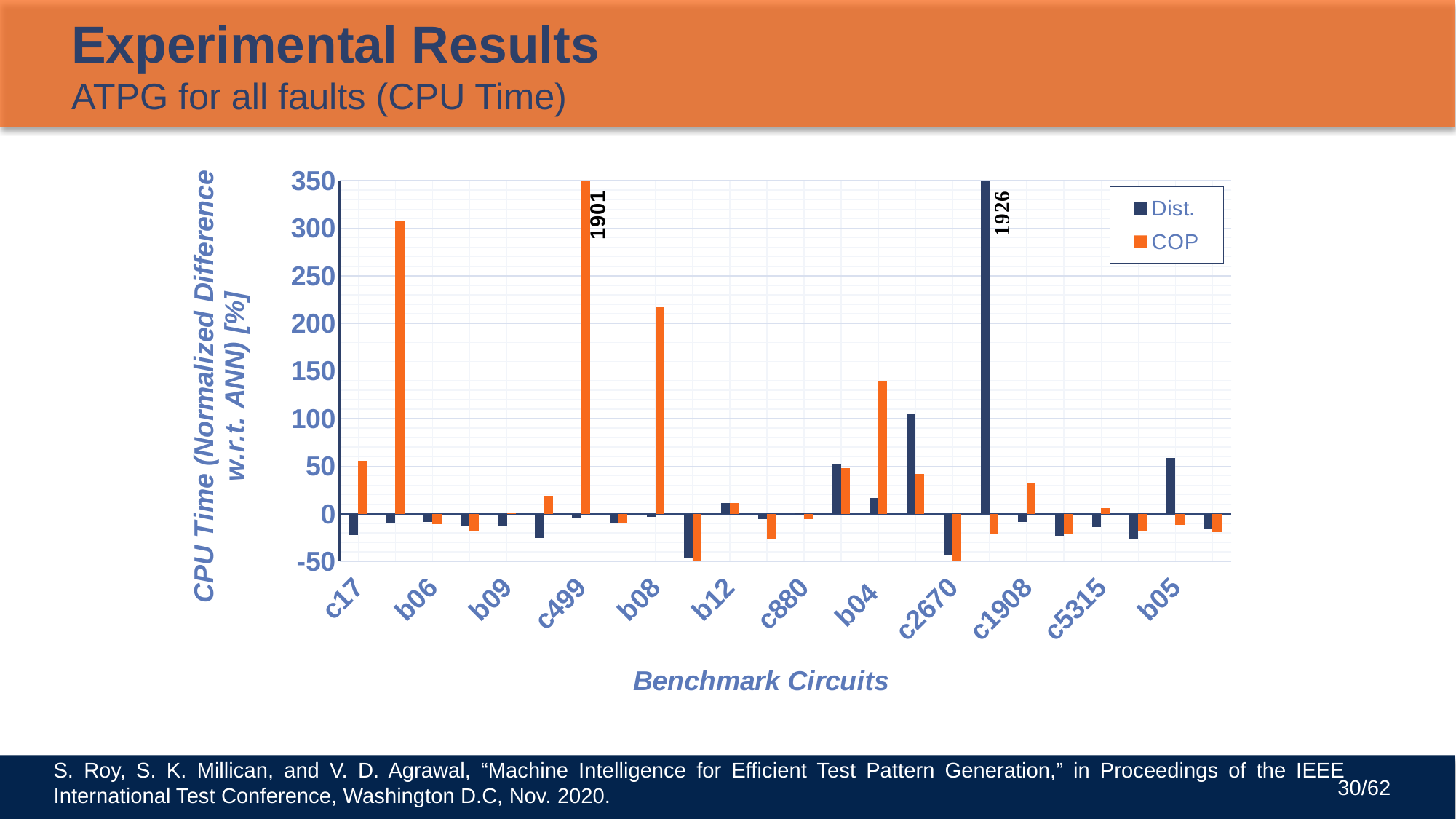
What kind of chart is shown on the slide? bar chart What is the title of the y axis? CPU Time (Normalized Difference w.r.t. ANN) [%] Which series does the bar labeled 1901 belong to? COP What is the highest value printed on the chart? 1926 What are the two series named in the legend? Dist. and COP How many series does the legend list? 2 Which is larger, the labeled Dist. bar (1926) or the labeled COP bar (1901)? Dist. (1926) What is the highest tick value shown on the y axis? 350 What is the difference between the two printed data labels, 1926 and 1901? 25 Is the value of the COP bar labeled 1901 greater or less than 350? greater What is the lowest tick value shown on the y axis? -50 Which series does the bar labeled 1926 belong to? Dist.